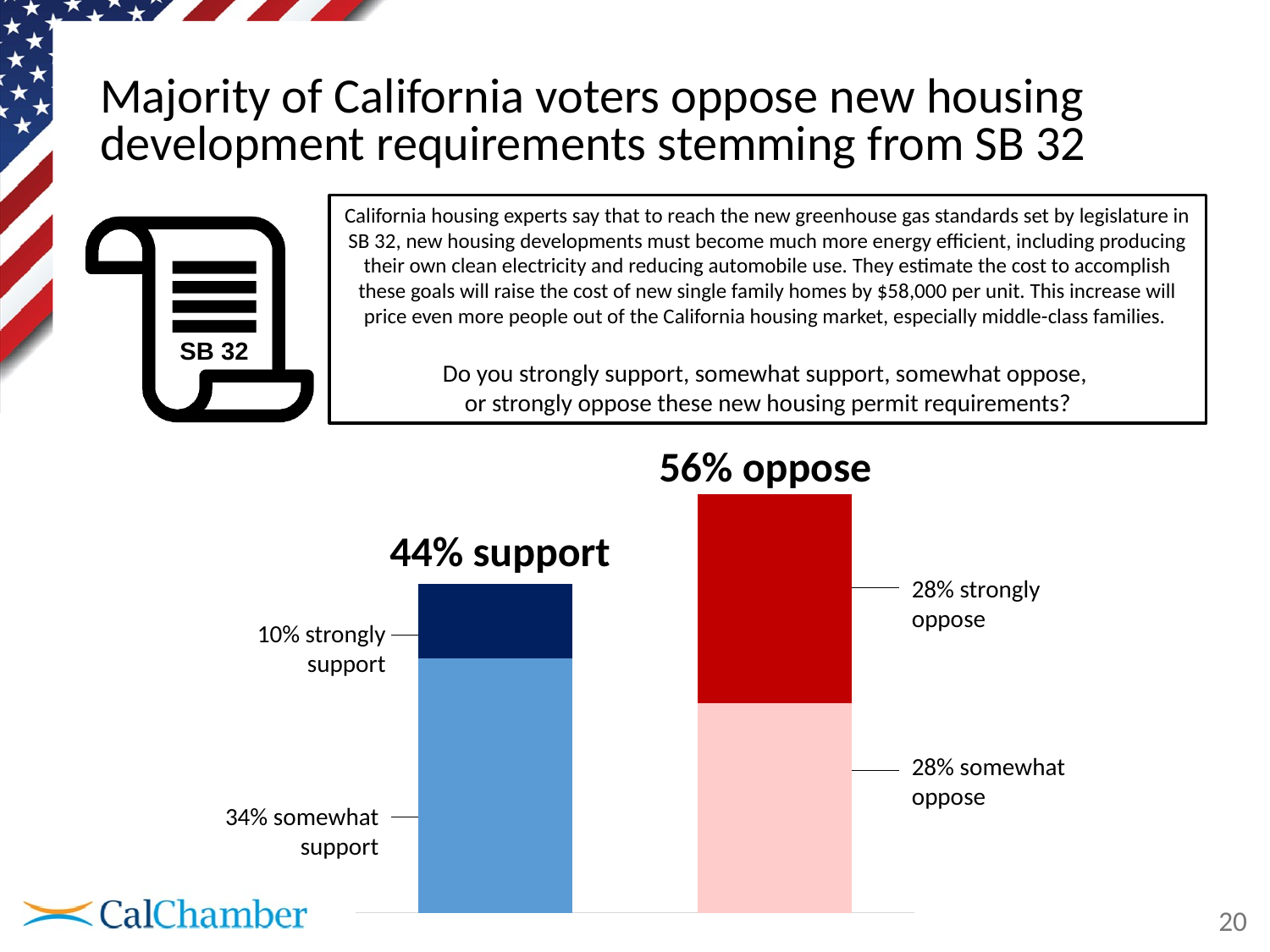
What percentage of voters somewhat support the new housing permit requirements? 34% How many stacked bars are shown in the chart? 2 What kind of chart is shown on the slide? stacked bar chart What percentage of voters somewhat oppose the new housing permit requirements? 28% What percentage of voters strongly support the new housing permit requirements? 10% Which response category has the smallest percentage? strongly support What percentage of voters strongly oppose the new housing permit requirements? 28% Which is larger, the total support bar or the total oppose bar? oppose What is the total percentage of voters who oppose the new housing permit requirements? 56% What is the difference between the somewhat support and strongly support percentages? 24% What is the difference between the total oppose percentage and the total support percentage? 12% What is the total percentage of voters who support the new housing permit requirements? 44%